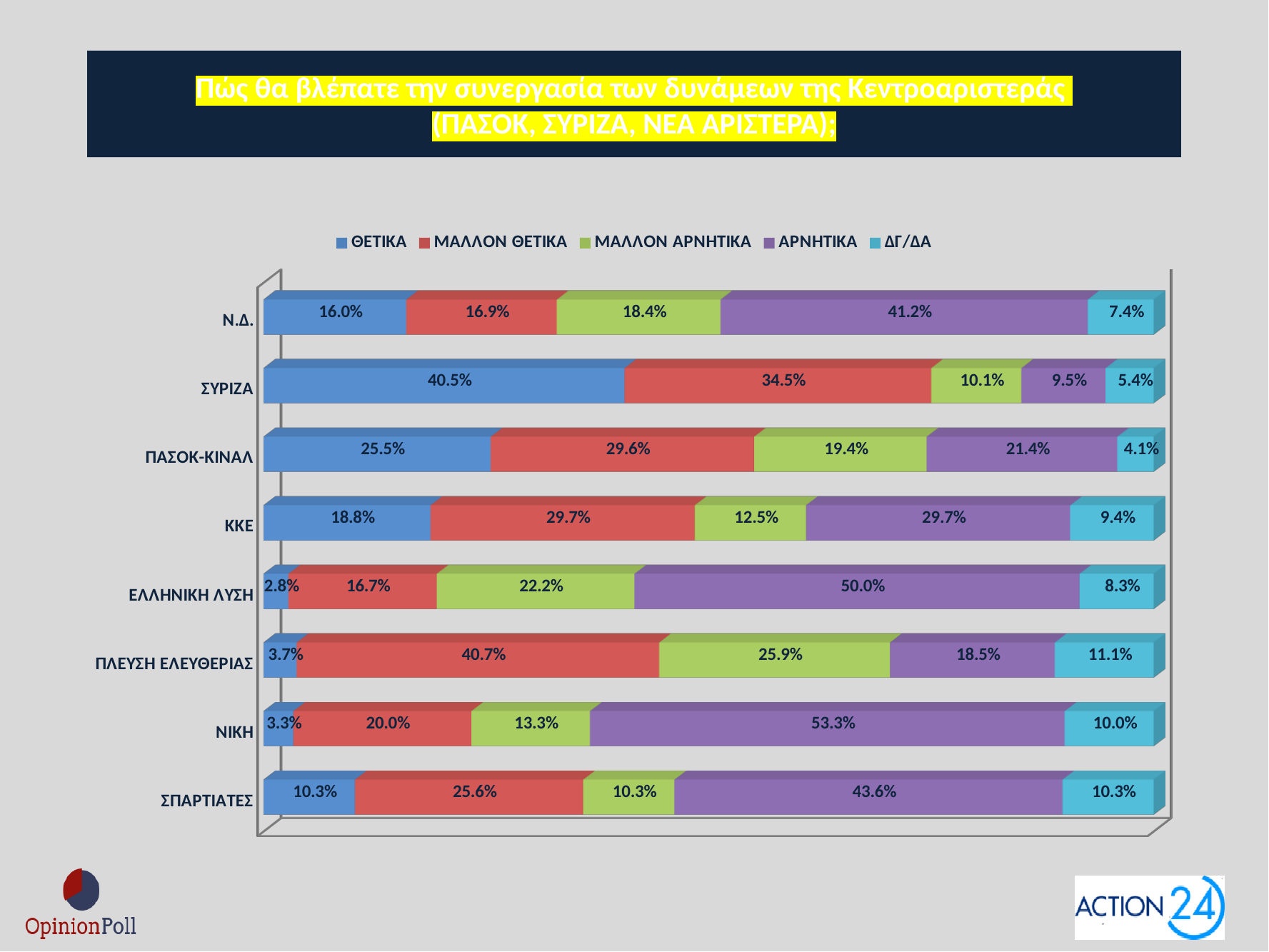
What kind of chart is shown on the slide? Stacked bar chart What is the total of the stacked bar for ΣΥΡΙΖΑ? 100.0% Which category has the highest ΑΡΝΗΤΙΚΑ value? ΝΙΚΗ What is the difference between the ΘΕΤΙΚΑ values for ΣΥΡΙΖΑ and Ν.Δ.? 24.5 percentage points What is the ΔΓ/ΔΑ value for ΠΛΕΥΣΗ ΕΛΕΥΘΕΡΙΑΣ? 11.1% How many series does the legend list? 5 Which category has the lowest ΘΕΤΙΚΑ value? ΕΛΛΗΝΙΚΗ ΛΥΣΗ Which is larger: the ΜΑΛΛΟΝ ΘΕΤΙΚΑ value for ΠΛΕΥΣΗ ΕΛΕΥΘΕΡΙΑΣ or for ΚΚΕ? ΠΛΕΥΣΗ ΕΛΕΥΘΕΡΙΑΣ What is the ΘΕΤΙΚΑ value for ΠΑΣΟΚ-ΚΙΝΑΛ? 25.5% Which category has the highest ΘΕΤΙΚΑ value? ΣΥΡΙΖΑ What percentage of Ν.Δ. respondents answered ΑΡΝΗΤΙΚΑ? 41.2% How many categories (parties) are shown on the chart? 8